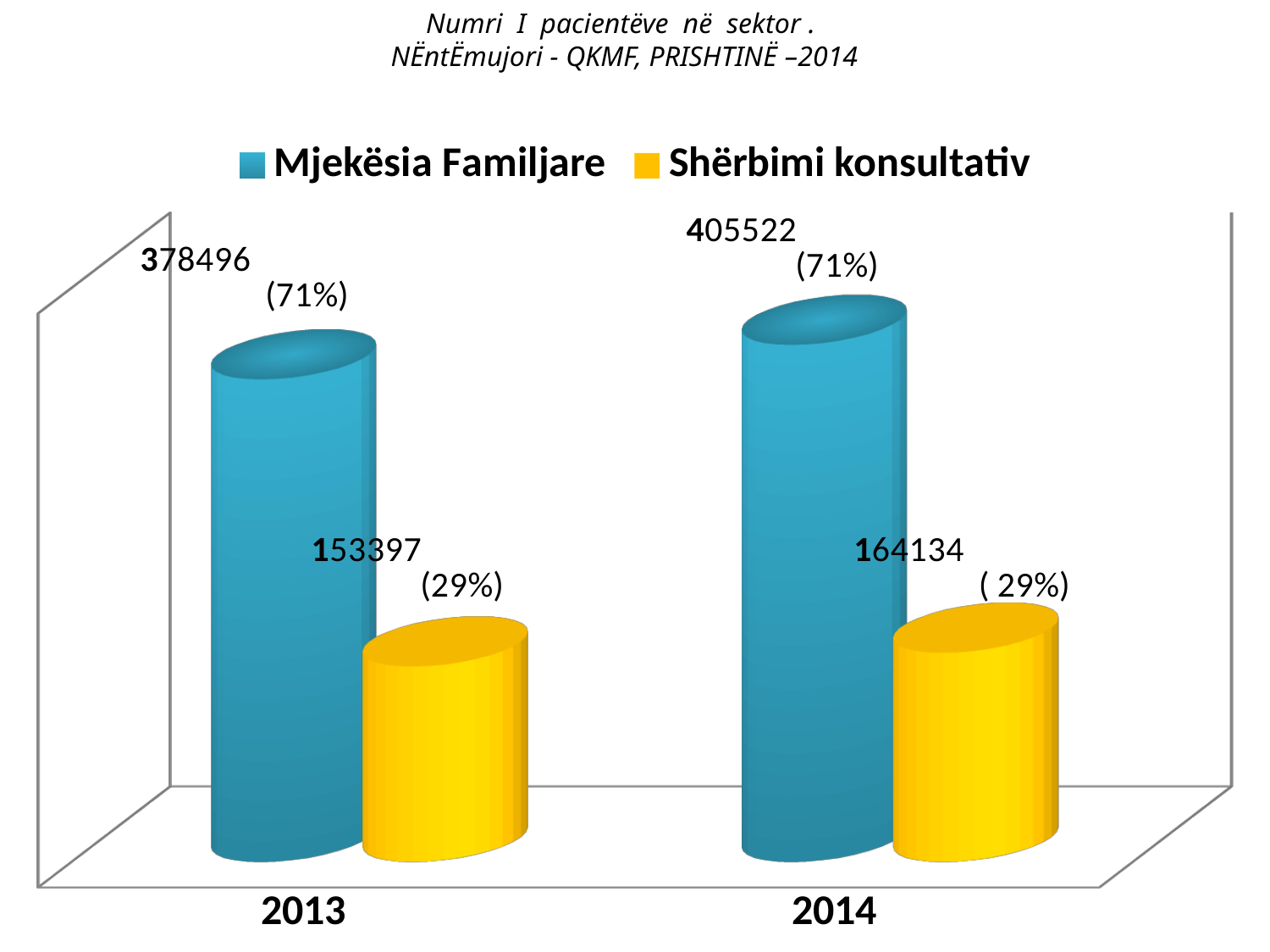
Which bar has the lowest value on the chart? Shërbimi konsultativ in 2013 What kind of chart is shown on the slide? Bar chart What is the value for Shërbimi konsultativ in 2013? 153397 What is the difference between Mjekësia Familjare and Shërbimi konsultativ in 2013? 225099 What is the value for Mjekësia Familjare in 2014? 405522 Which bar has the highest value on the chart? Mjekësia Familjare in 2014 What percentage is shown for Shërbimi konsultativ in 2013? 29% Which is larger in 2014: Mjekësia Familjare or Shërbimi konsultativ? Mjekësia Familjare How many series does the legend list? 2 What is the value for Shërbimi konsultativ in 2014? 164134 By how much did the value for Mjekësia Familjare increase from 2013 to 2014? 27026 What is the value for Mjekësia Familjare in 2013? 378496